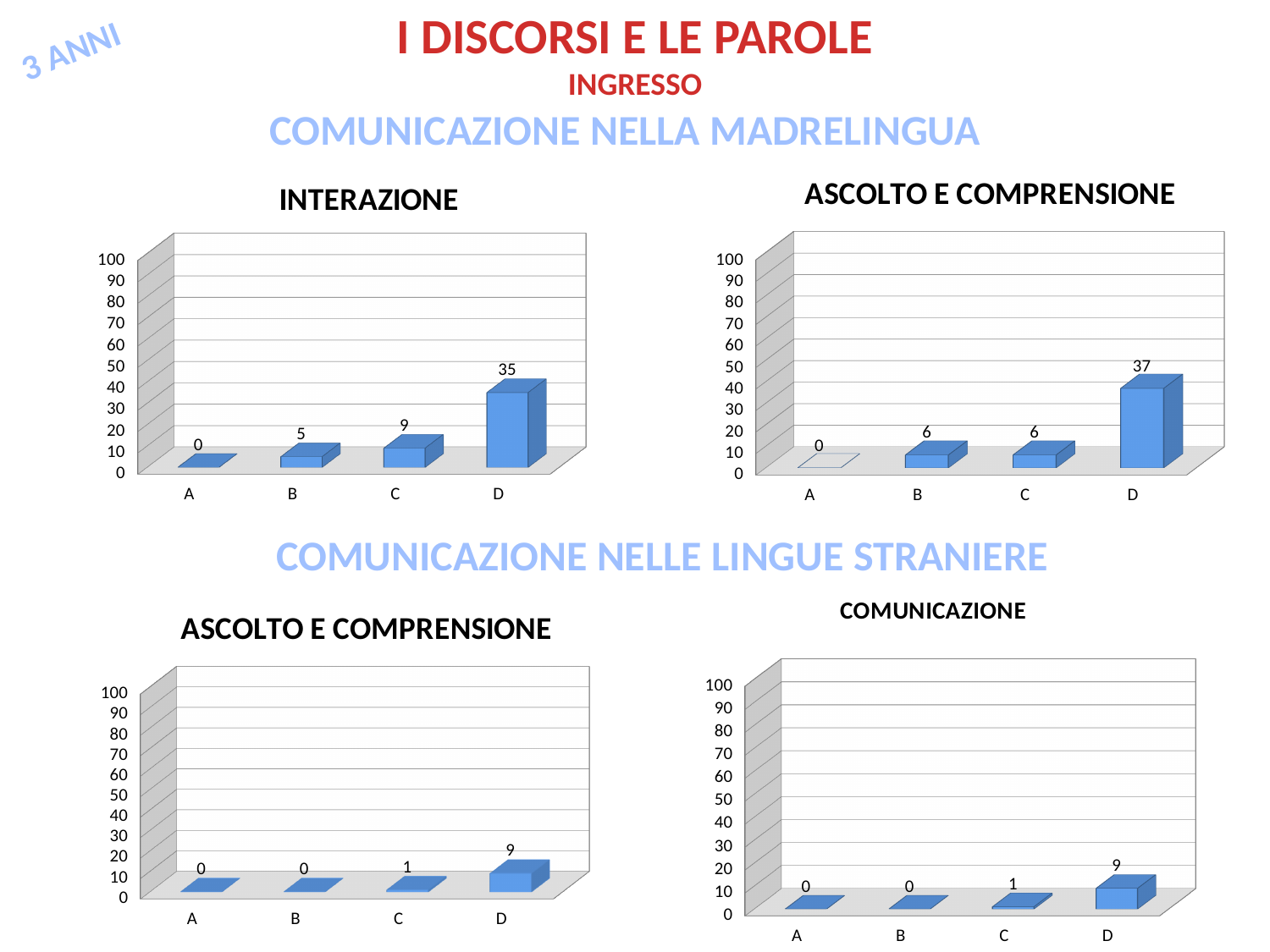
In the ASCOLTO E COMPRENSIONE chart under COMUNICAZIONE NELLA MADRELINGUA (top right), which category has the highest value? D In the ASCOLTO E COMPRENSIONE chart under COMUNICAZIONE NELLE LINGUE STRANIERE (bottom left), what is the value for category C? 1 In the ASCOLTO E COMPRENSIONE chart under COMUNICAZIONE NELLA MADRELINGUA (top right), what is the value for category B? 6 In the COMUNICAZIONE chart (bottom right), what is the value for category D? 9 In the ASCOLTO E COMPRENSIONE chart under COMUNICAZIONE NELLE LINGUE STRANIERE (bottom left), how many categories are shown on the x axis? 4 In the ASCOLTO E COMPRENSIONE chart under COMUNICAZIONE NELLA MADRELINGUA (top right), what is the value for category D? 37 Which is larger: the value for D in the INTERAZIONE chart or the value for D in the top-right ASCOLTO E COMPRENSIONE chart? D in ASCOLTO E COMPRENSIONE (37) In the COMUNICAZIONE chart (bottom right), is the value for D greater or less than 20? less What kind of chart is the INTERAZIONE chart? Bar chart In the INTERAZIONE chart, what is the value for category D? 35 In the INTERAZIONE chart, which category has the lowest value? A In the INTERAZIONE chart, what is the difference between the values for D and C? 26